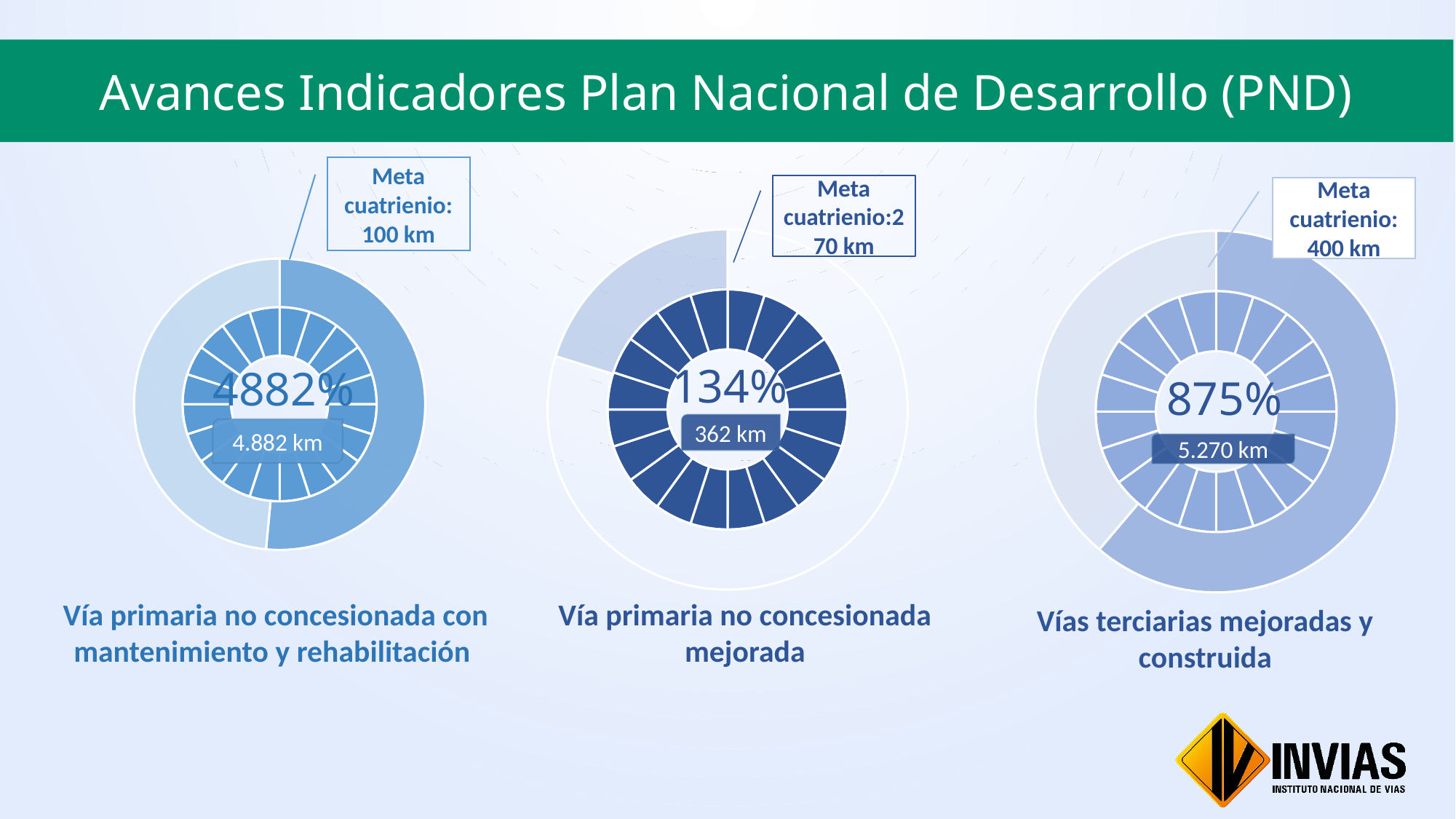
What is the 'Meta cuatrienio' for 'Vía primaria no concesionada con mantenimiento y rehabilitación'? 100 km How many km are reported for 'Vía primaria no concesionada con mantenimiento y rehabilitación'? 4.882 km What percentage is shown in the centre of the chart for 'Vía primaria no concesionada mejorada'? 134% What is the difference in km between 'Vías terciarias mejoradas y construida' (5.270 km) and 'Vía primaria no concesionada con mantenimiento y rehabilitación' (4.882 km)? 388 km What percentage is shown in the centre of the chart for 'Vías terciarias mejoradas y construida'? 875% What percentage is shown in the centre of the chart for 'Vía primaria no concesionada con mantenimiento y rehabilitación'? 4882% How many km are reported for 'Vías terciarias mejoradas y construida'? 5.270 km How many charts are shown on the slide? 3 Which of the three indicators shows the highest percentage of progress? Vía primaria no concesionada con mantenimiento y rehabilitación Which of the three indicators shows the lowest percentage of progress? Vía primaria no concesionada mejorada What is the 'Meta cuatrienio' for 'Vías terciarias mejoradas y construida'? 400 km How many km are reported for 'Vía primaria no concesionada mejorada'? 362 km